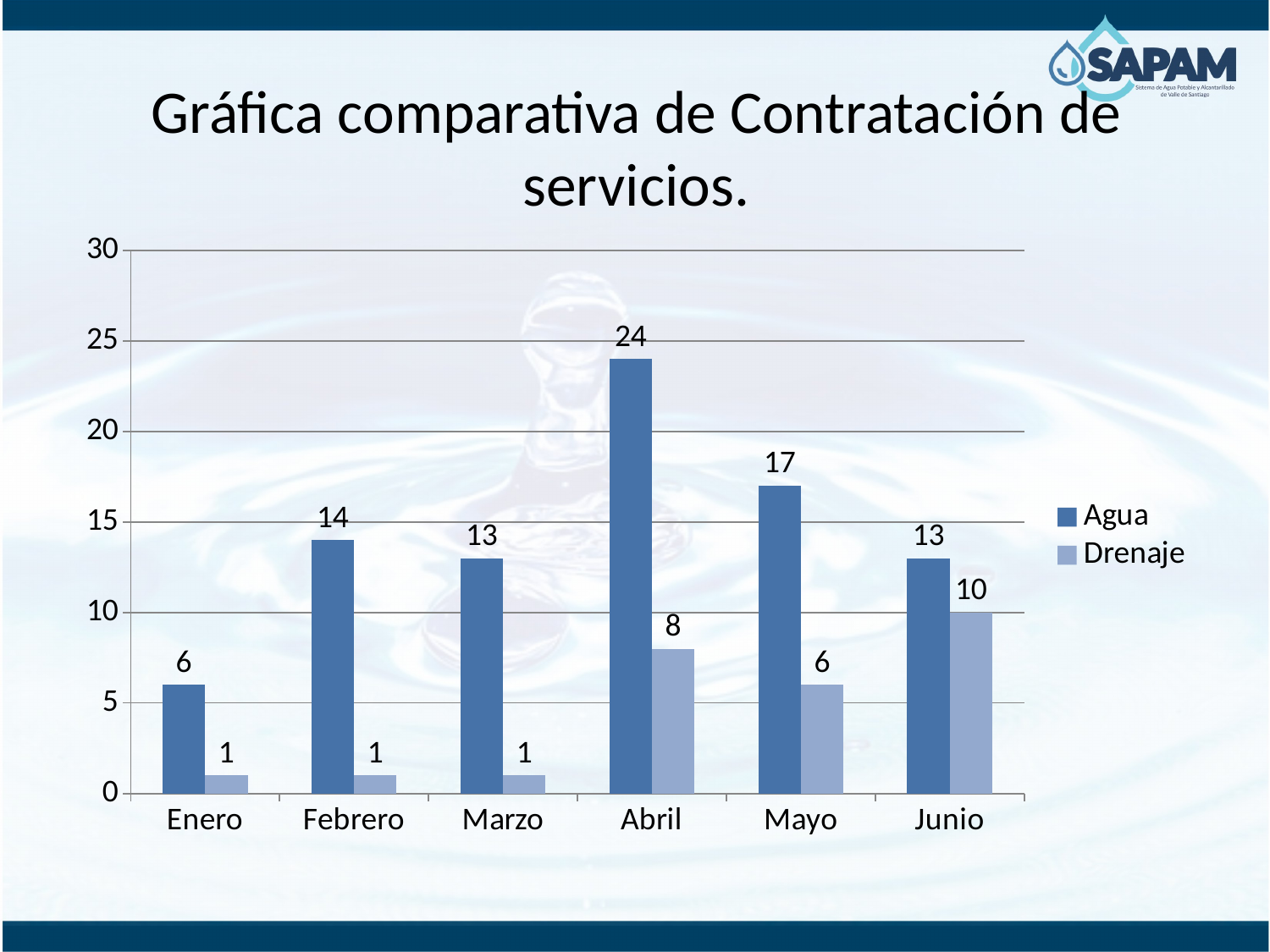
What is the Agua value for Abril? 24 What kind of chart is shown on the slide? bar chart Which month has the lowest Agua value? Enero What is the Agua value for Enero? 6 What is the Drenaje value for Junio? 10 How many months are shown on the x axis? 6 Is the Agua value for Febrero greater or less than 10? greater What is the difference between the Agua and Drenaje values for Mayo? 11 Which is larger, the Drenaje value for Abril or the Drenaje value for Junio? Junio Which month has the highest Agua value? Abril How many series does the legend list? 2 What is the title of the chart on the slide? Gráfica comparativa de Contratación de servicios.